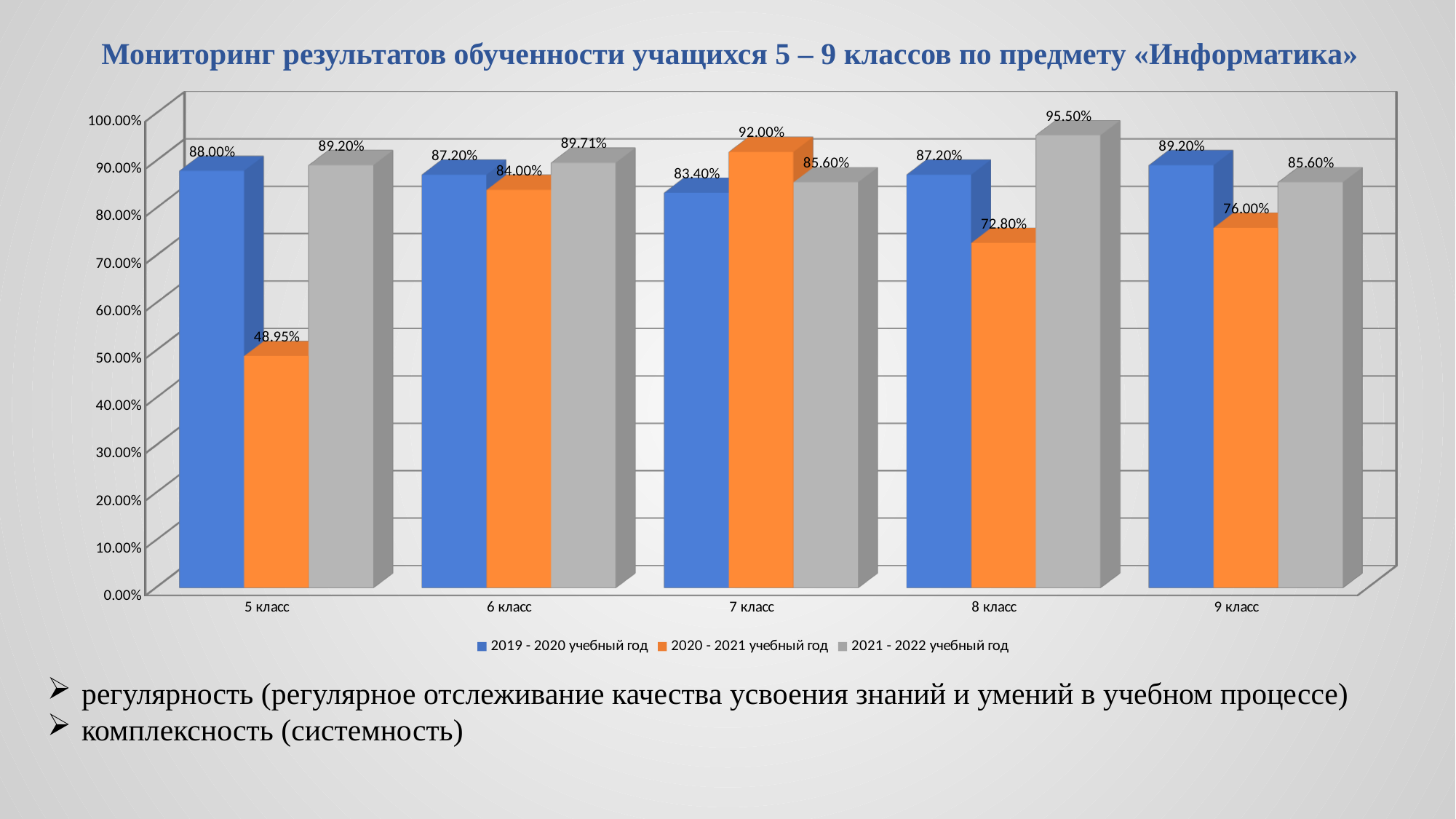
Which class has the highest value in the 2021 - 2022 учебный год series? 8 класс What is the value for 5 класс in the 2020 - 2021 учебный год series? 48.95% What is the difference between the 2021 - 2022 and 2020 - 2021 values for 5 класс? 40.25% How many series does the legend list? 3 Which is larger for 7 класс: the 2020 - 2021 value or the 2021 - 2022 value? 2020 - 2021 учебный год Which colour represents the 2021 - 2022 учебный год series? Grey Is the value for 8 класс in the 2020 - 2021 учебный год series greater or less than 80.00%? less What is the value for 7 класс in the 2019 - 2020 учебный год series? 83.40% What is the value for 8 класс in the 2021 - 2022 учебный год series? 95.50% Which class has the lowest value in the 2020 - 2021 учебный год series? 5 класс What kind of chart is shown on the slide? Bar chart How many classes (categories) are shown on the x axis? 5